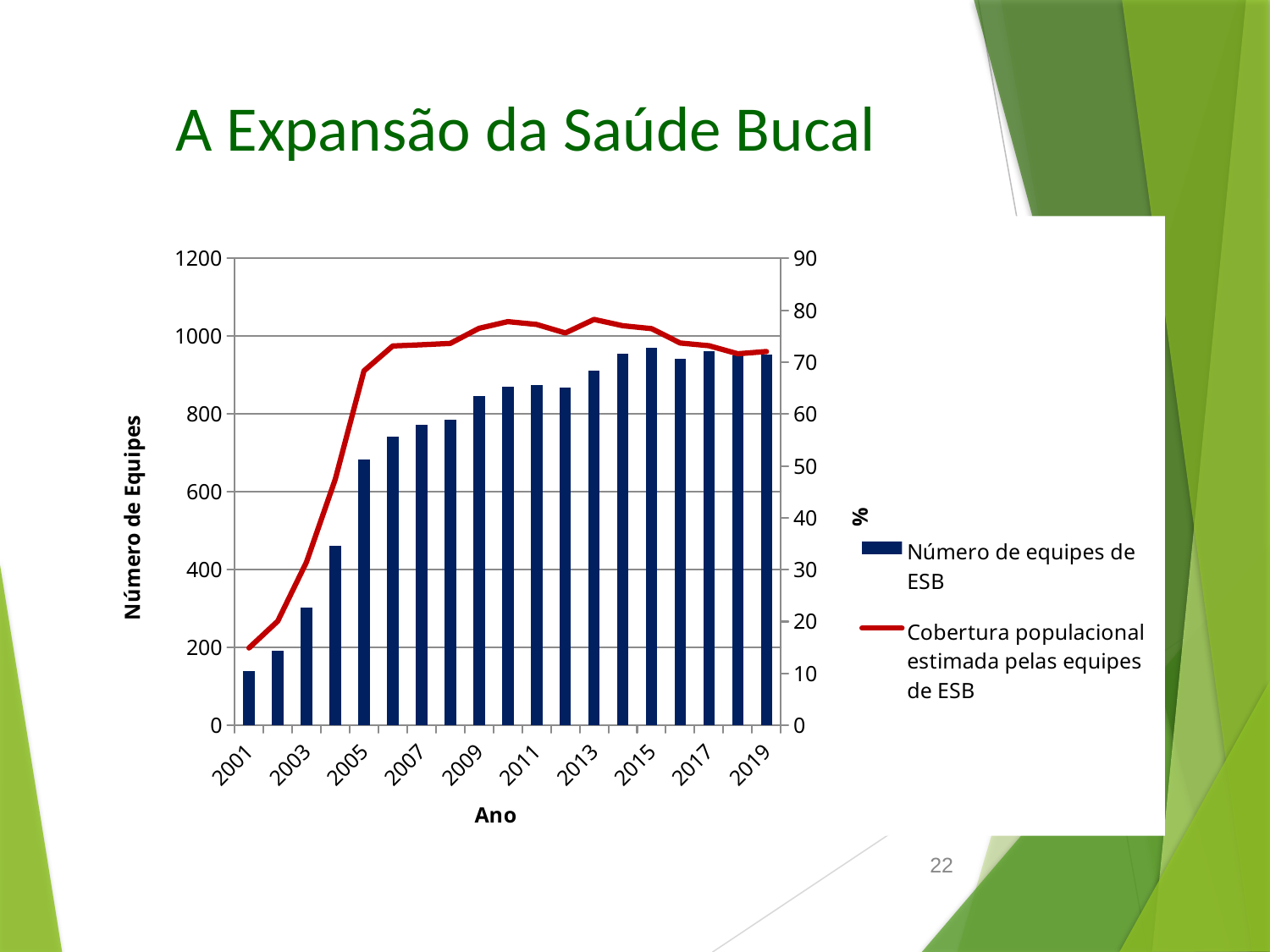
What is the title of the left vertical axis? Número de Equipes Which year has the lowest number of ESB teams (Número de equipes de ESB)? 2001 Is the number of ESB teams in 2019 greater or less than 1000? less Is the estimated population coverage (Cobertura populacional) in 2010 greater or less than 70%? greater Is the number of ESB teams in 2005 greater or less than 600? greater Which year has more ESB teams, 2003 or 2007? 2007 What kind of chart is shown on the slide? A combined bar and line chart Does the number of ESB teams rise or fall from 2001 to 2009? rise How many years are plotted along the x axis? 19 How many series does the legend list? 2